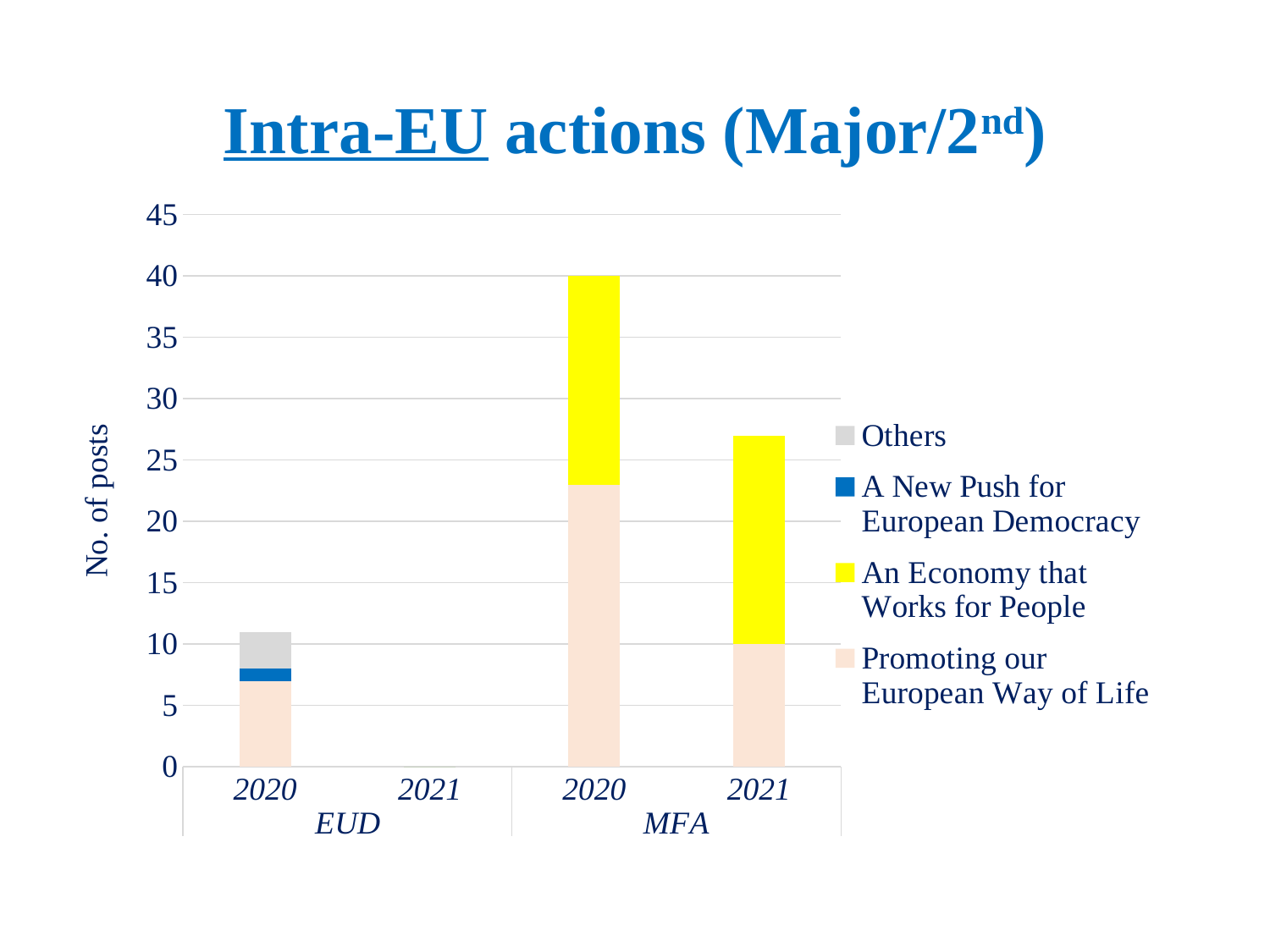
What kind of chart is shown on the slide? Stacked bar chart What is the label of the y axis? No. of posts Which series is shown in yellow in the legend? An Economy that Works for People Is the total for the MFA 2021 bar greater or less than 25? greater Is the 'Promoting our European Way of Life' segment for MFA 2020 greater or less than 20? greater How many series does the legend list? 4 Is the total for the EUD 2020 bar greater or less than 15? less Which bar is taller, MFA 2020 or MFA 2021? MFA 2020 How many year categories are shown along the x axis? 4 Which bar has the highest total number of posts? MFA 2020 What is the total number of posts for the MFA 2020 bar? 40 What is the value of the 'Promoting our European Way of Life' segment for MFA 2021? 10